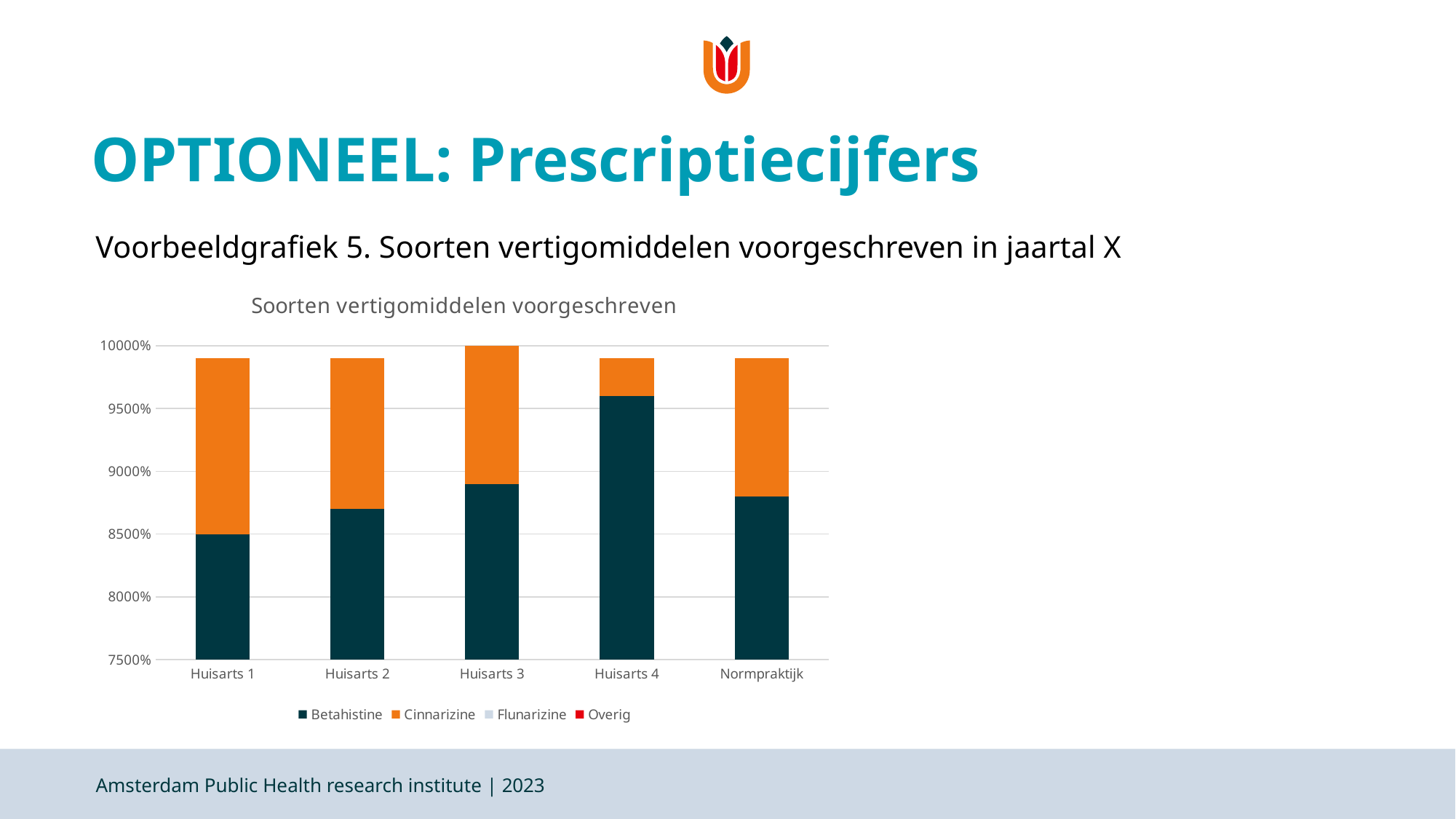
Which practice has the lowest Betahistine value? Huisarts 1 Which practice has the highest Betahistine value? Huisarts 4 Which series is shown in orange in the chart? Cinnarizine What is the title of the chart? Soorten vertigomiddelen voorgeschreven Is the Betahistine value for Huisarts 4 greater or less than 9500%? greater Is the Betahistine value for Normpraktijk greater or less than 9000%? less What is the total height of the stacked bar for Huisarts 3? 10000% How many practices (categories) are shown on the x axis of the chart? 5 What is the Betahistine value for Huisarts 1? 8500% How many series does the chart's legend list? 4 Which is larger: the Betahistine value for Huisarts 2 or for Huisarts 3? Huisarts 3 What kind of chart is shown on the slide? stacked bar chart